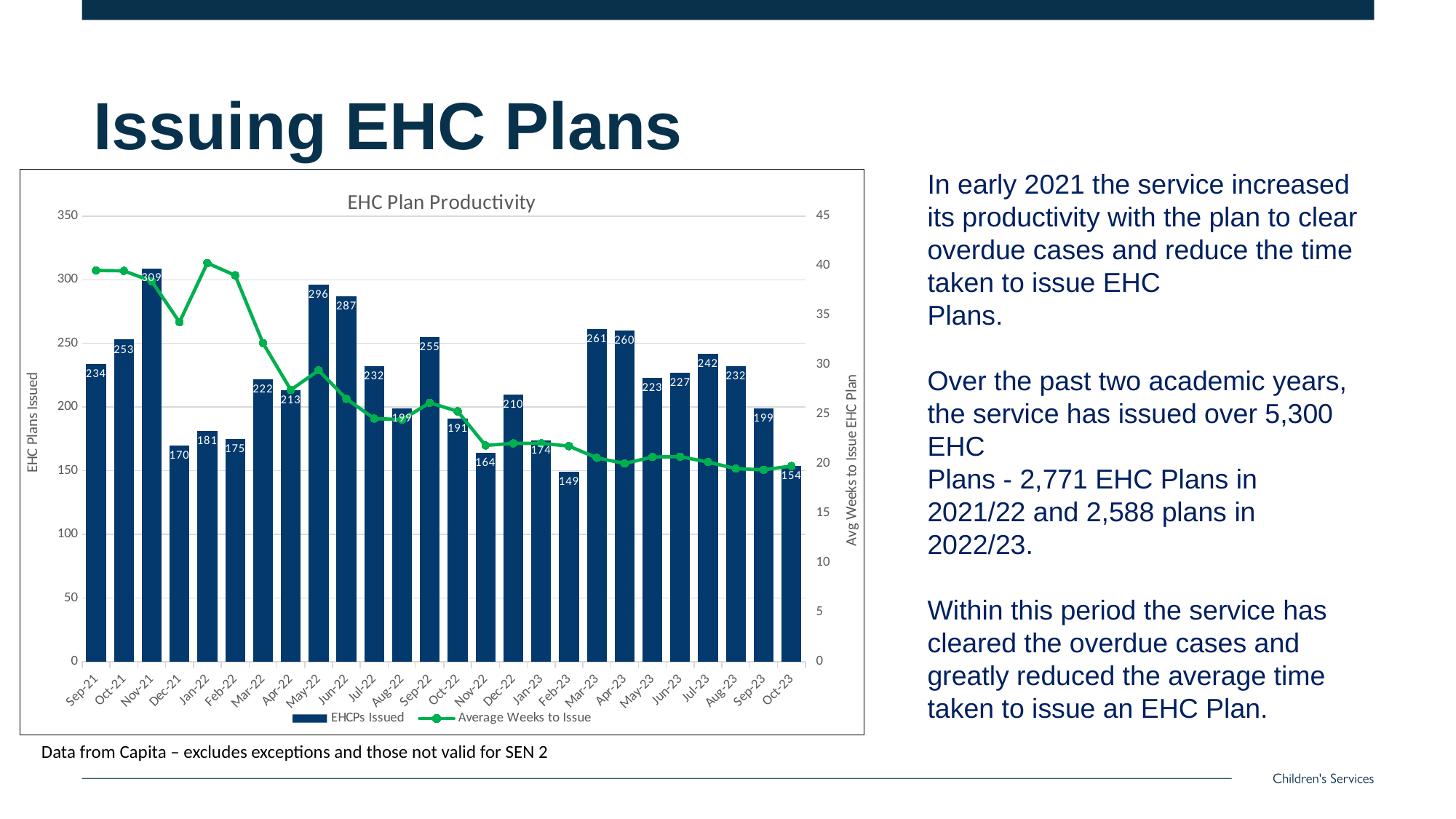
How many series does the legend of the EHC Plan Productivity chart list? 2 How many EHC Plans were issued in Nov-21 according to the EHC Plan Productivity chart? 309 What is the difference between the EHCPs Issued in May-22 and Jun-22? 9 Does the Average Weeks to Issue line generally rise or fall from Sep-21 to Oct-23? fall Which month has the lowest number of EHCPs Issued in the EHC Plan Productivity chart? Feb-23 Which month had more EHCPs Issued, Mar-23 or Oct-23? Mar-23 Is the Average Weeks to Issue value for Sep-21 greater or less than 35? greater How many months are shown on the x axis of the EHC Plan Productivity chart? 26 Is the Average Weeks to Issue value for Oct-23 greater or less than 25? less What type of chart is used for the EHCPs Issued series in the EHC Plan Productivity chart? bar chart Which month has the highest number of EHCPs Issued in the EHC Plan Productivity chart? Nov-21 How many EHC Plans were issued in Feb-23 according to the EHC Plan Productivity chart? 149